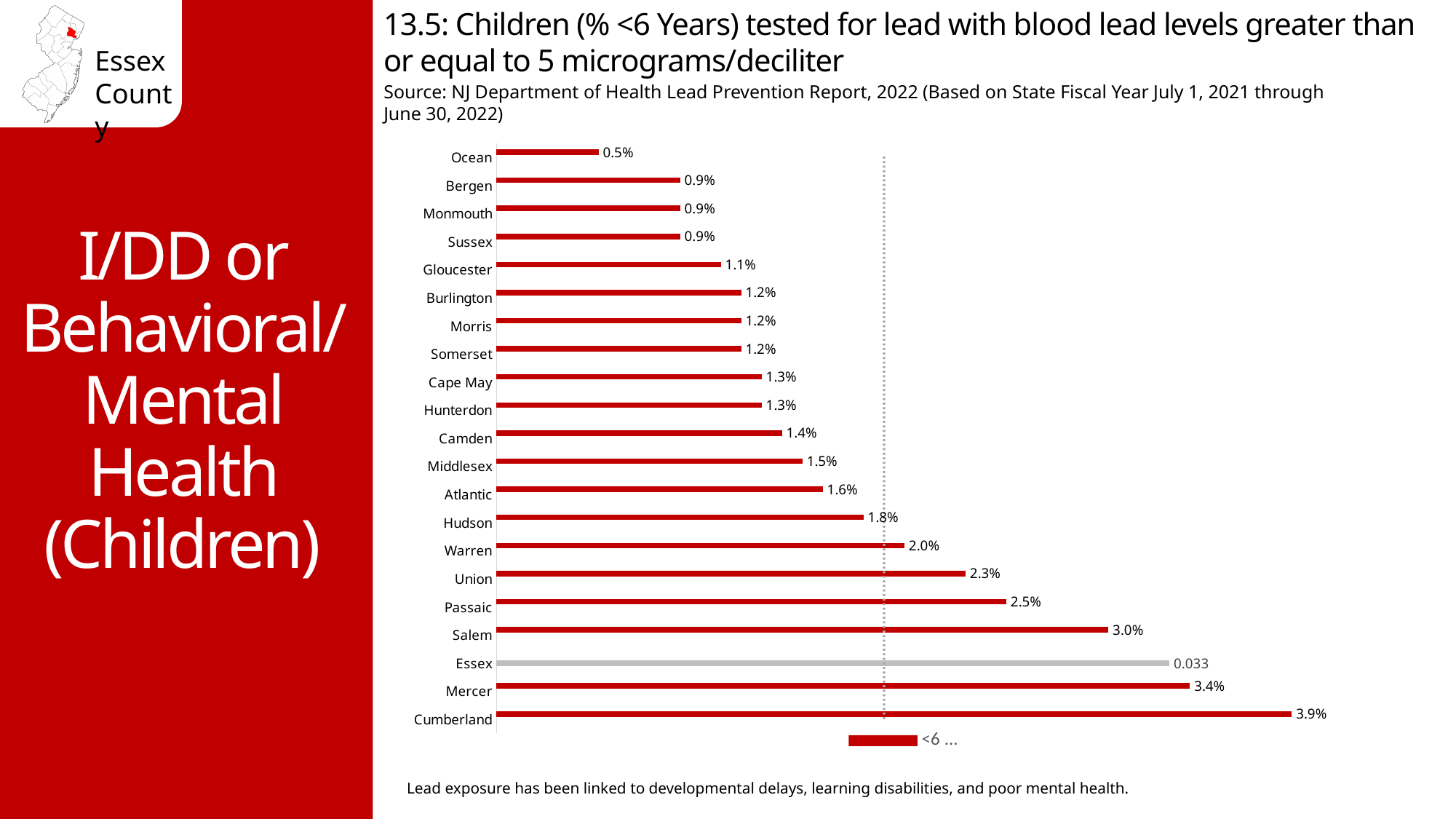
Which has a larger value, Atlantic or Camden? Atlantic What is the value for Hudson? 1.8% What value is printed next to the Essex bar? 0.033 What kind of chart is shown on the slide? Bar chart Which county has the lowest value? Ocean How many counties are shown in the chart? 21 Which county's bar is drawn in gray instead of red? Essex What is the difference between the values for Mercer and Salem? 0.4% Which has a larger value, Passaic or Union? Passaic Which county has the highest value? Cumberland What is the difference between the values for Cumberland and Ocean? 3.4% What is the value for Cumberland? 3.9%